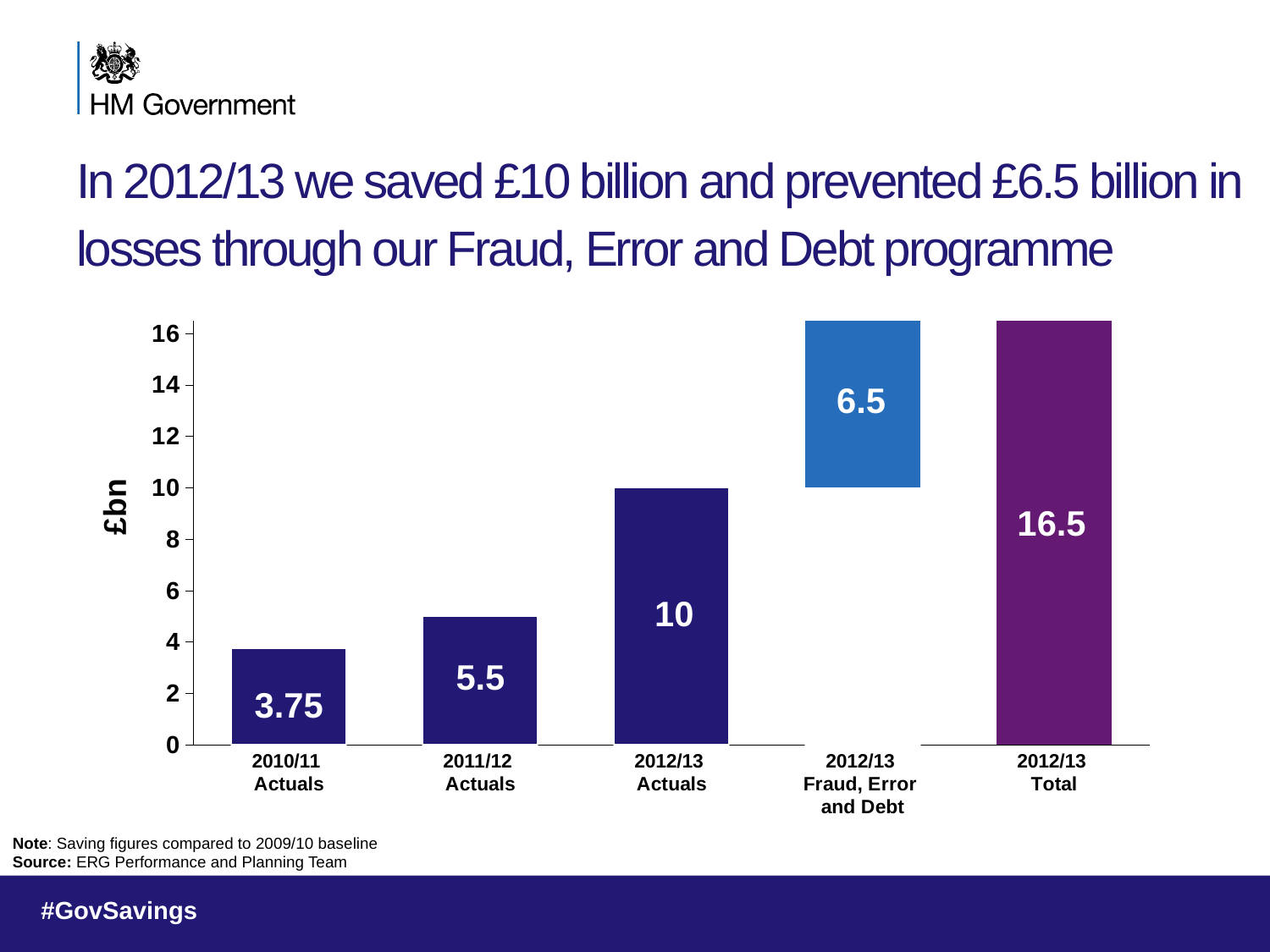
What is the label on the y axis? £bn What is the value for 2010/11 Actuals? 3.75 How many categories are shown on the x axis? 5 What is the value for 2012/13 Total? 16.5 What is the value for 2012/13 Actuals? 10 What kind of chart is this? Bar chart What is the difference between 2012/13 Actuals and 2011/12 Actuals? 4.5 Which category has the lowest value? 2010/11 Actuals Which is larger, 2011/12 Actuals or 2012/13 Fraud, Error and Debt? 2012/13 Fraud, Error and Debt What is the value shown for 2012/13 Fraud, Error and Debt? 6.5 What is the value for 2011/12 Actuals? 5.5 Which category has the highest value? 2012/13 Total